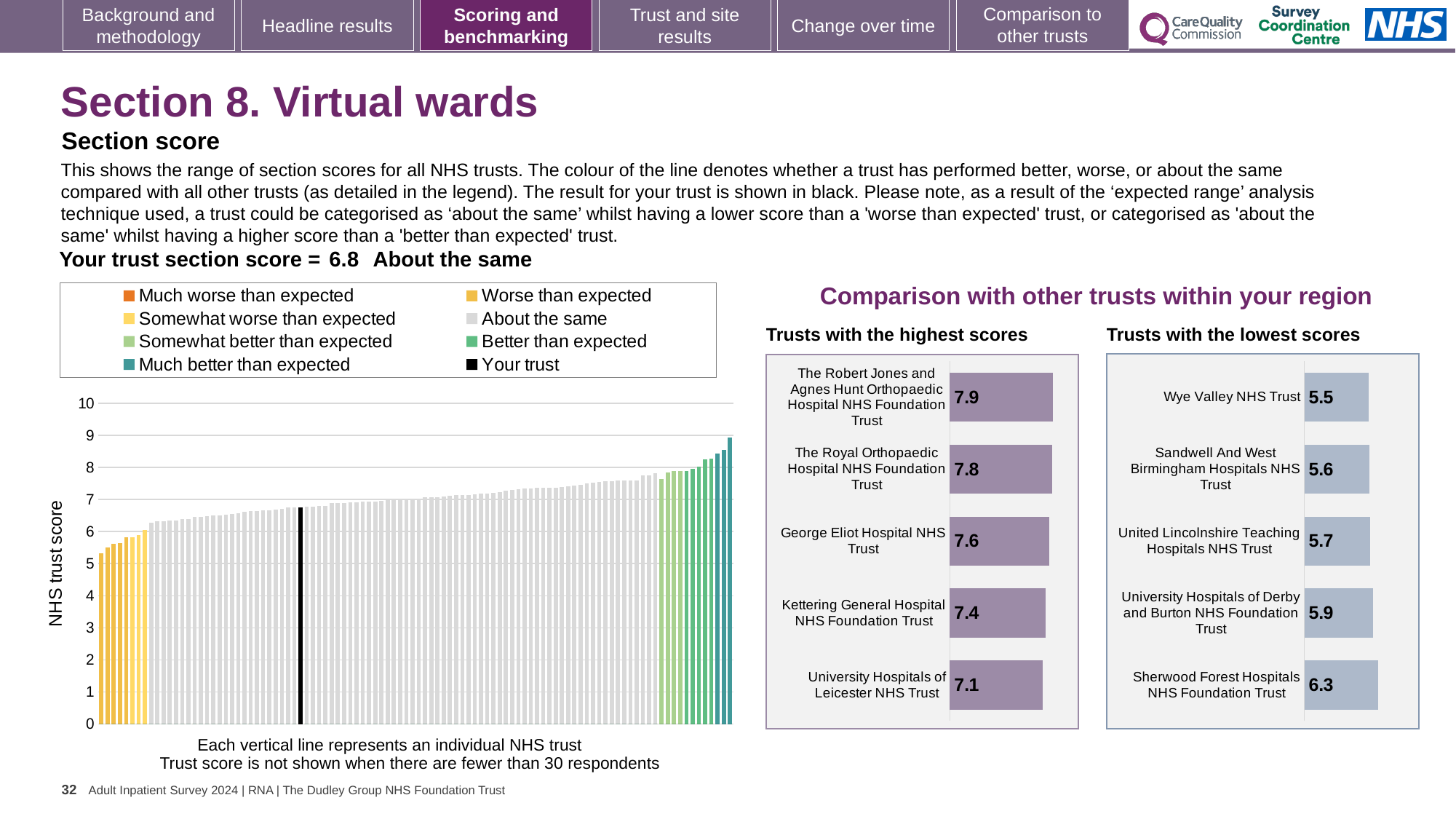
In the 'Trusts with the lowest scores' chart, what is the score for Wye Valley NHS Trust? 5.5 In the 'Trusts with the highest scores' chart, what is the score for University Hospitals of Leicester NHS Trust? 7.1 In the 'Trusts with the highest scores' chart, which trust has the lowest score? University Hospitals of Leicester NHS Trust How many trusts are shown in the 'Trusts with the lowest scores' chart? 5 In the NHS trust score chart on the left, is the value for your trust (the black bar) greater or less than 6? greater In the NHS trust score chart on the left, do the values rise or fall from left to right? rise In the 'Trusts with the highest scores' chart, which has the larger score: George Eliot Hospital NHS Trust or Kettering General Hospital NHS Foundation Trust? George Eliot Hospital NHS Trust In the 'Trusts with the highest scores' chart, what is the difference between the scores of The Robert Jones and Agnes Hunt Orthopaedic Hospital NHS Foundation Trust and University Hospitals of Leicester NHS Trust? 0.8 How many entries does the legend of the NHS trust score chart on the left list? 8 In the 'Trusts with the lowest scores' chart, what is the difference between the scores of Sherwood Forest Hospitals NHS Foundation Trust and Wye Valley NHS Trust? 0.8 In the 'Trusts with the highest scores' chart, what is the score for The Robert Jones and Agnes Hunt Orthopaedic Hospital NHS Foundation Trust? 7.9 In the 'Trusts with the lowest scores' chart, which trust has the highest score? Sherwood Forest Hospitals NHS Foundation Trust